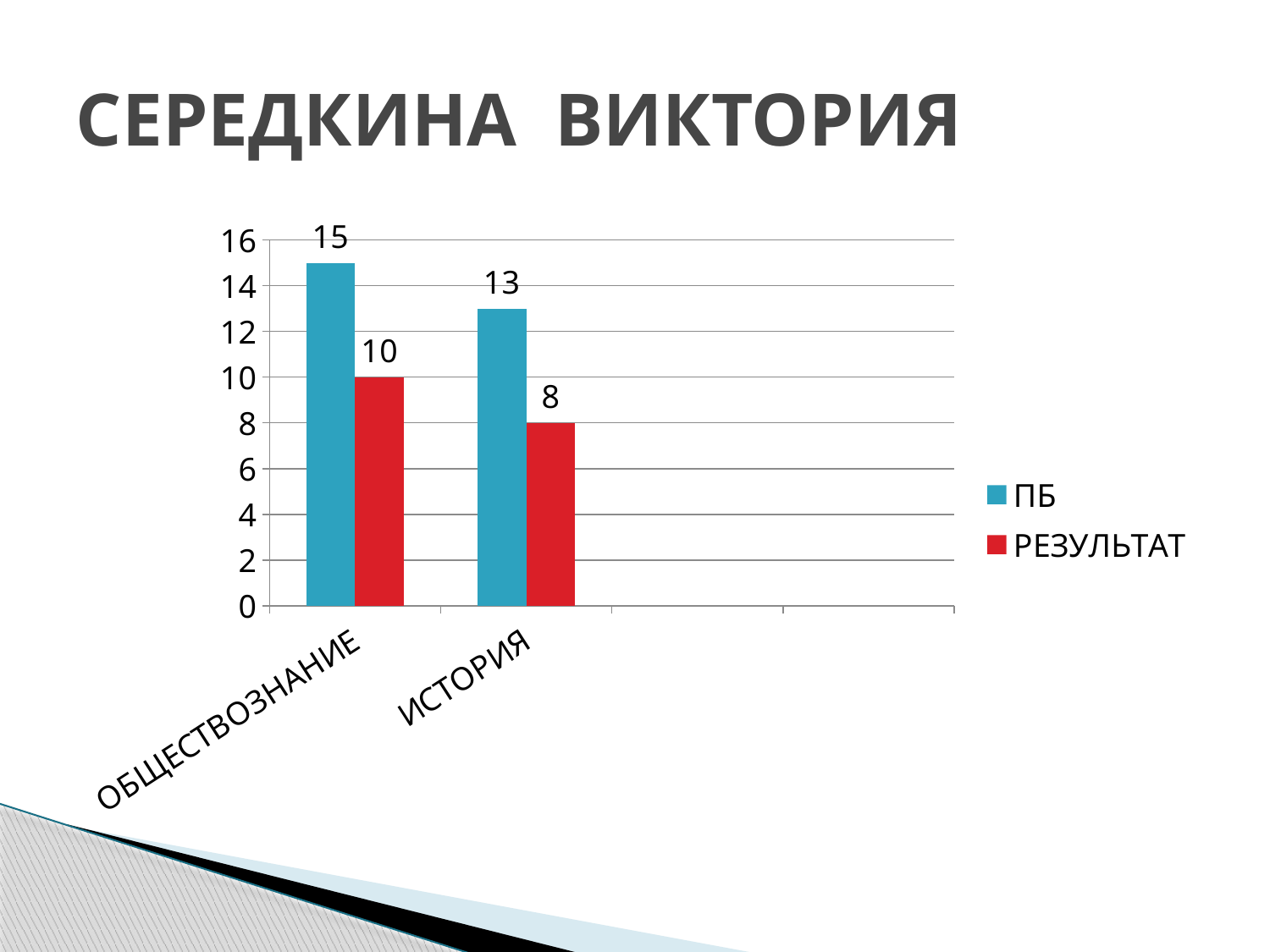
Which category has the lowest РЕЗУЛЬТАТ value? ИСТОРИЯ What is the РЕЗУЛЬТАТ value for ОБЩЕСТВОЗНАНИЕ? 10 How many categories are shown on the x axis? 2 What is the ПБ value for ОБЩЕСТВОЗНАНИЕ? 15 What is the difference between the ПБ values for ОБЩЕСТВОЗНАНИЕ and ИСТОРИЯ? 2 What is the difference between the ПБ and РЕЗУЛЬТАТ values for ОБЩЕСТВОЗНАНИЕ? 5 What kind of chart is shown on the slide? bar chart Which is larger for ИСТОРИЯ, ПБ or РЕЗУЛЬТАТ? ПБ What is the РЕЗУЛЬТАТ value for ИСТОРИЯ? 8 What is the ПБ value for ИСТОРИЯ? 13 Which category has the highest ПБ value? ОБЩЕСТВОЗНАНИЕ How many series does the legend list? 2